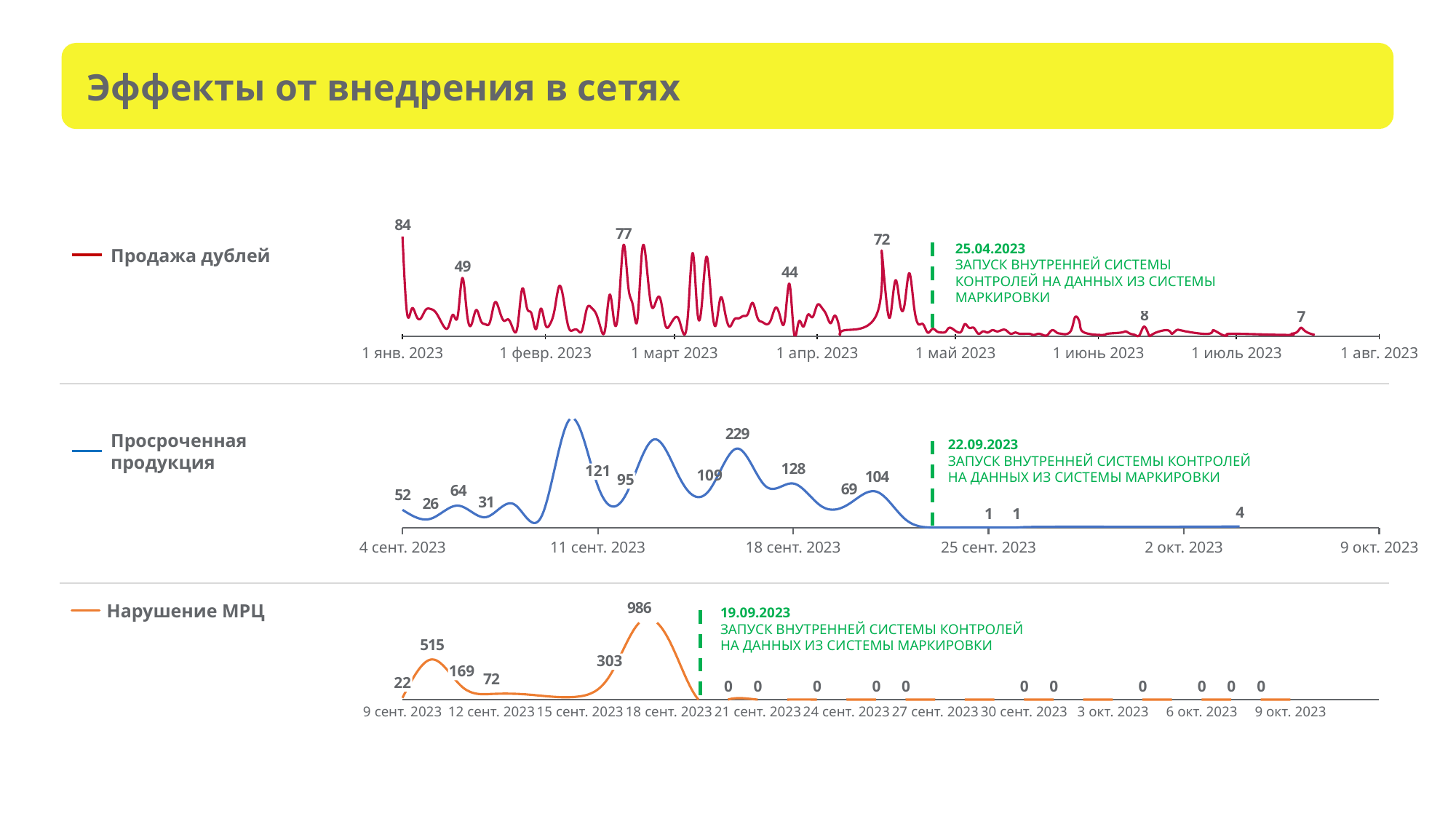
In the «Просроченная продукция» chart, what is the difference between the labelled values 229 and 128? 101 In the «Просроченная продукция» chart, what is the value at 4 сент. 2023? 52 In the «Нарушение МРЦ» chart, what is the difference between the values 986 and 515? 471 In the «Нарушение МРЦ» chart, what is the value at 9 сент. 2023? 22 How many charts are shown on the slide? 3 In the «Продажа дублей» chart, what is the difference between the labelled values 84 and 7? 77 In the «Просроченная продукция» chart, which labelled value is larger, 121 or 95? 121 In the «Продажа дублей» chart, on what date was the internal control system launched? 25.04.2023 What kind of chart is used for «Продажа дублей»? line chart In the «Нарушение МРЦ» chart, do the values rise or fall after the dashed line marking 19.09.2023? fall In the «Продажа дублей» chart, what is the highest labelled value? 84 In the «Нарушение МРЦ» chart, what is the highest value? 986